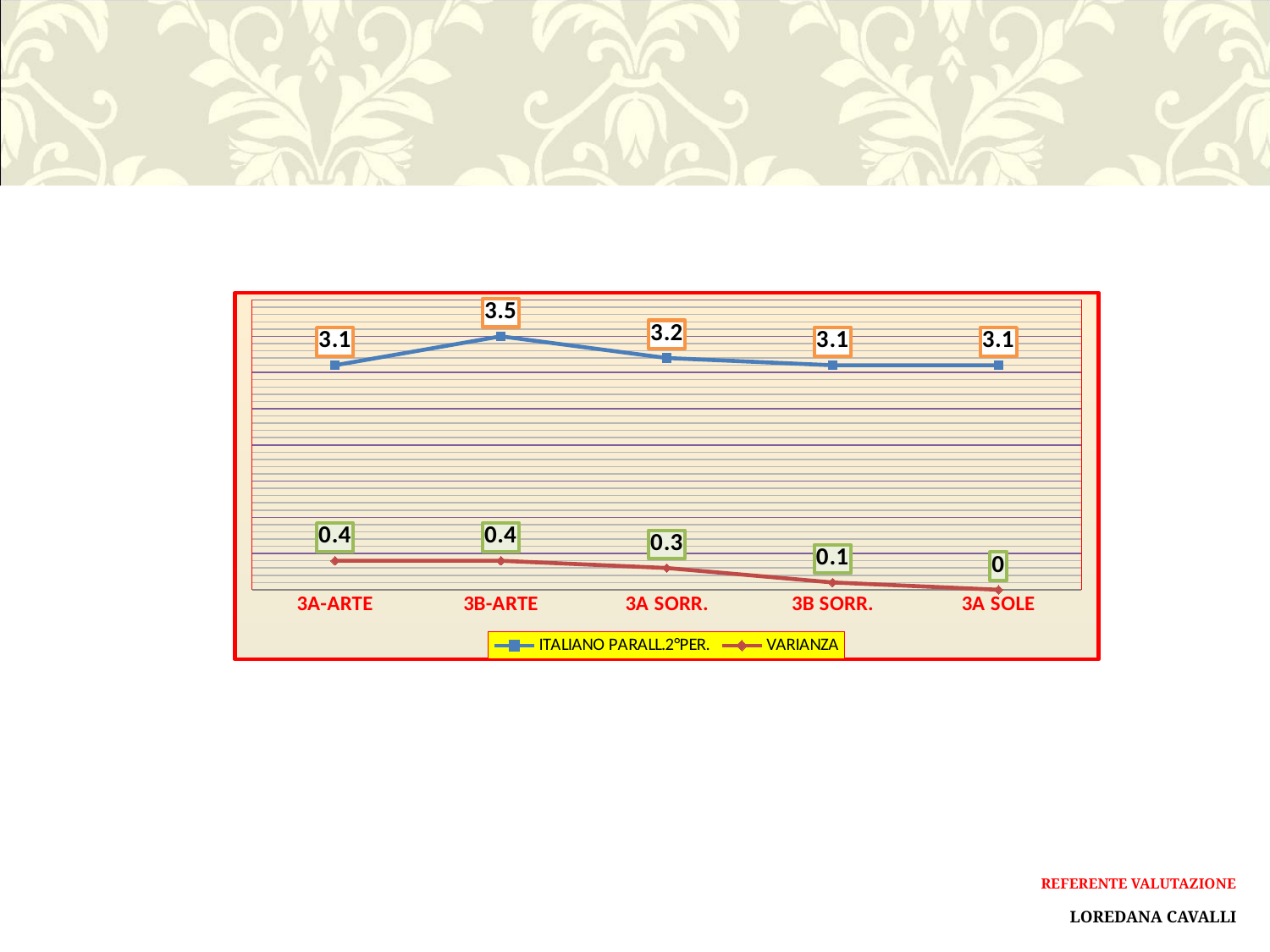
Does the VARIANZA series rise or fall from 3A-ARTE to 3A SOLE? fall How many series does the legend list? 2 How many categories are shown on the x axis? 5 Which is larger, the VARIANZA value for 3A-ARTE or for 3B SORR.? 3A-ARTE Which category has the highest ITALIANO PARALL.2°PER. value? 3B-ARTE What kind of chart is shown on the slide? line chart What colour is the line for the VARIANZA series? red Which category has the lowest VARIANZA value? 3A SOLE What is the difference between the ITALIANO PARALL.2°PER. values for 3B-ARTE and 3A SORR.? 0.3 What is the ITALIANO PARALL.2°PER. value for 3B-ARTE? 3.5 What is the VARIANZA value for 3A SORR.? 0.3 What is the VARIANZA value for 3A SOLE? 0